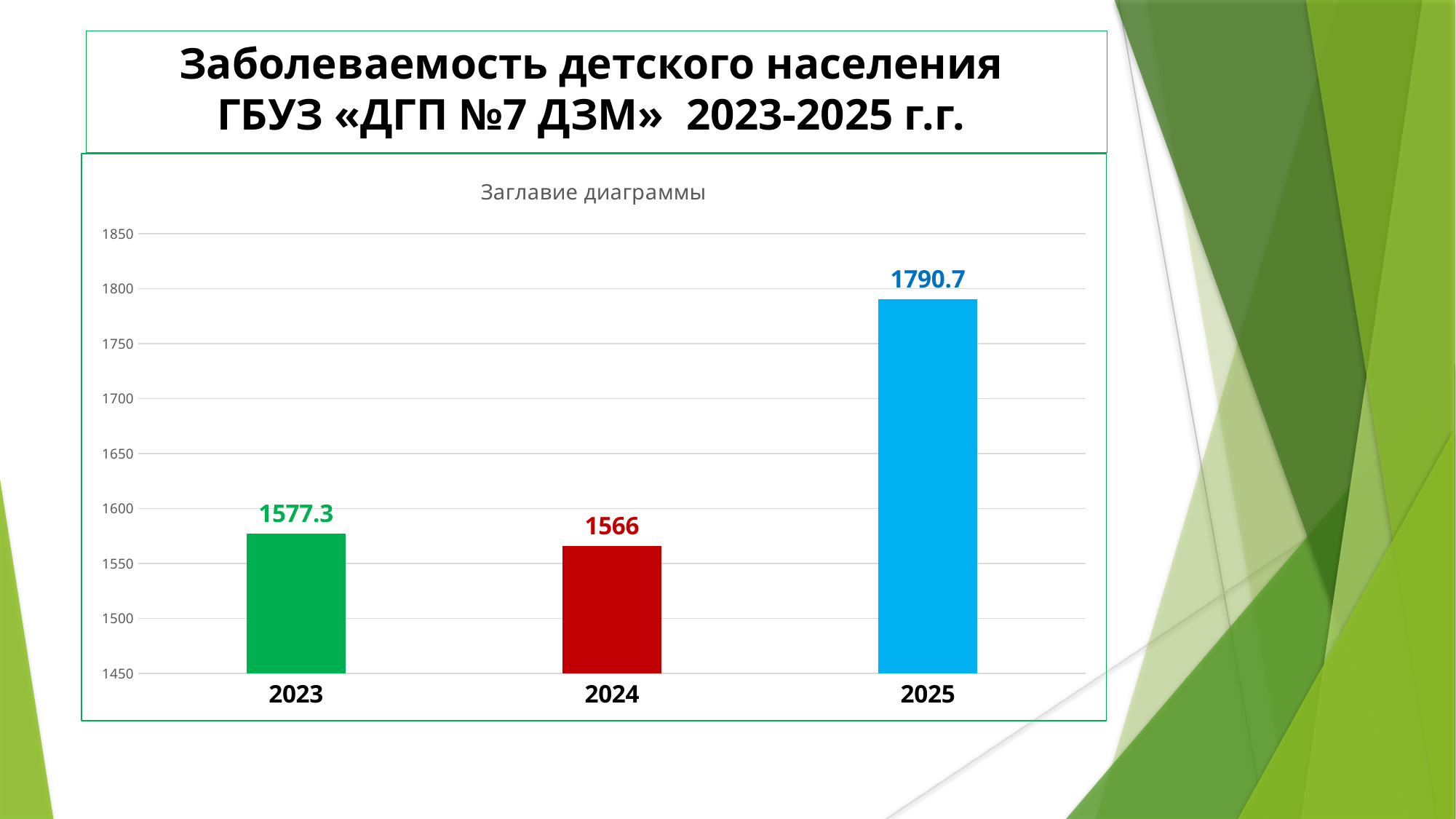
What kind of chart is shown on the slide? bar chart What colour is the bar for 2024? red What is the value for 2024? 1566 Is the value for 2025 greater or less than 1750? greater What is the difference between the values for 2025 and 2024? 224.7 How many years are shown on the chart? 3 What is the value for 2025? 1790.7 Which is larger, the value for 2023 or the value for 2025? 2025 What is the difference between the values for 2023 and 2024? 11.3 Which year has the lowest value? 2024 Which year has the highest value? 2025 What is the value for 2023? 1577.3